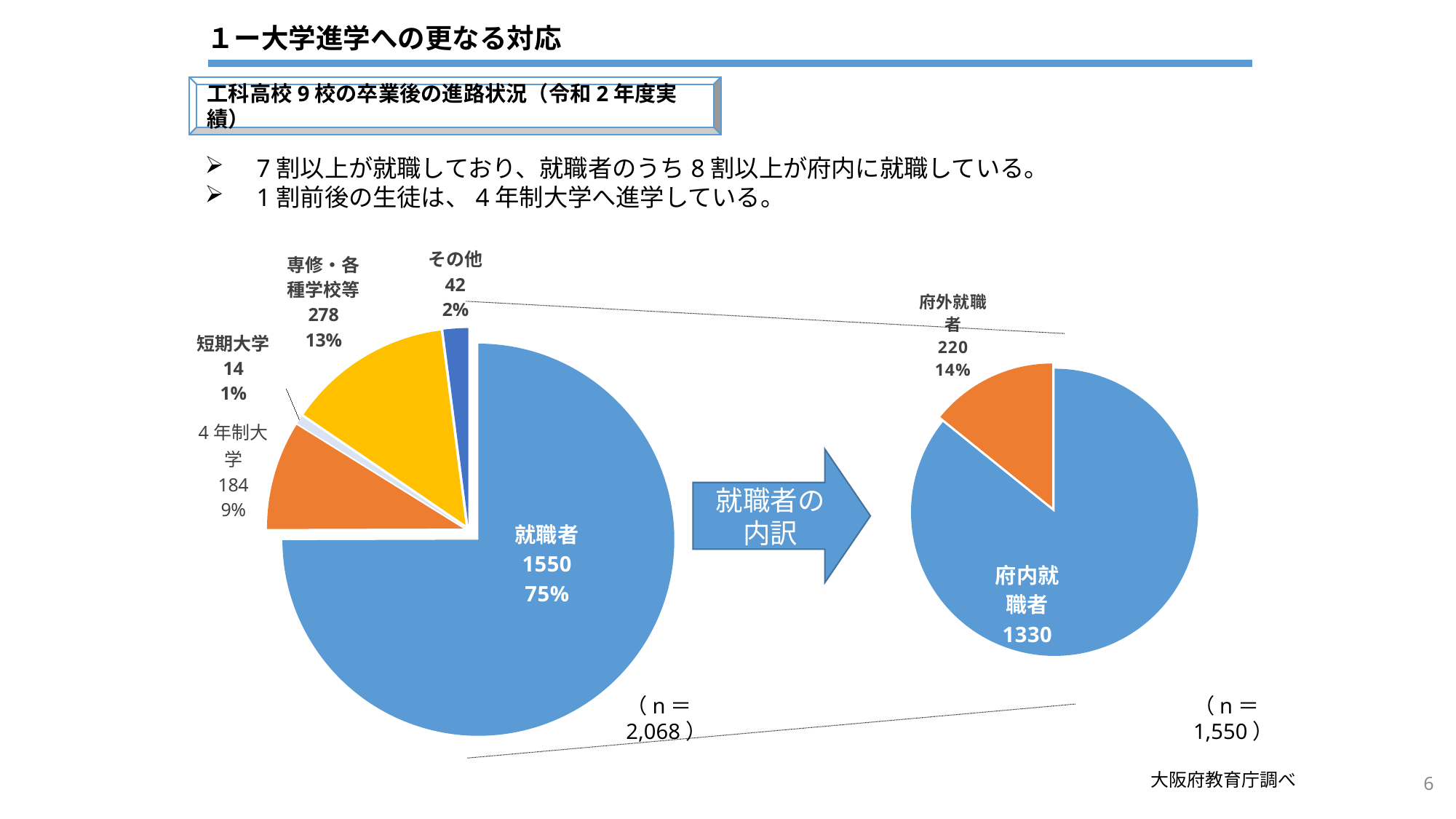
In the left pie chart, which category has the smallest value? 短期大学 In the left pie chart, what is the value for 4年制大学? 184 In the left pie chart, what is the difference between the values for 専修・各種学校等 and 4年制大学? 94 In the left pie chart, what percentage share is shown for 専修・各種学校等? 13% In the right pie chart, what percentage share is shown for 府外就職者? 14% What is the n value shown for the right pie chart? 1,550 In the left pie chart, which category has the largest value? 就職者 In the right pie chart, what is the value for 府内就職者? 1330 How many categories does the left pie chart show? 5 In the left pie chart, what is the value for 就職者? 1550 In the left pie chart, which is larger, その他 or 短期大学? その他 What kind of chart is the left chart on the slide? pie chart